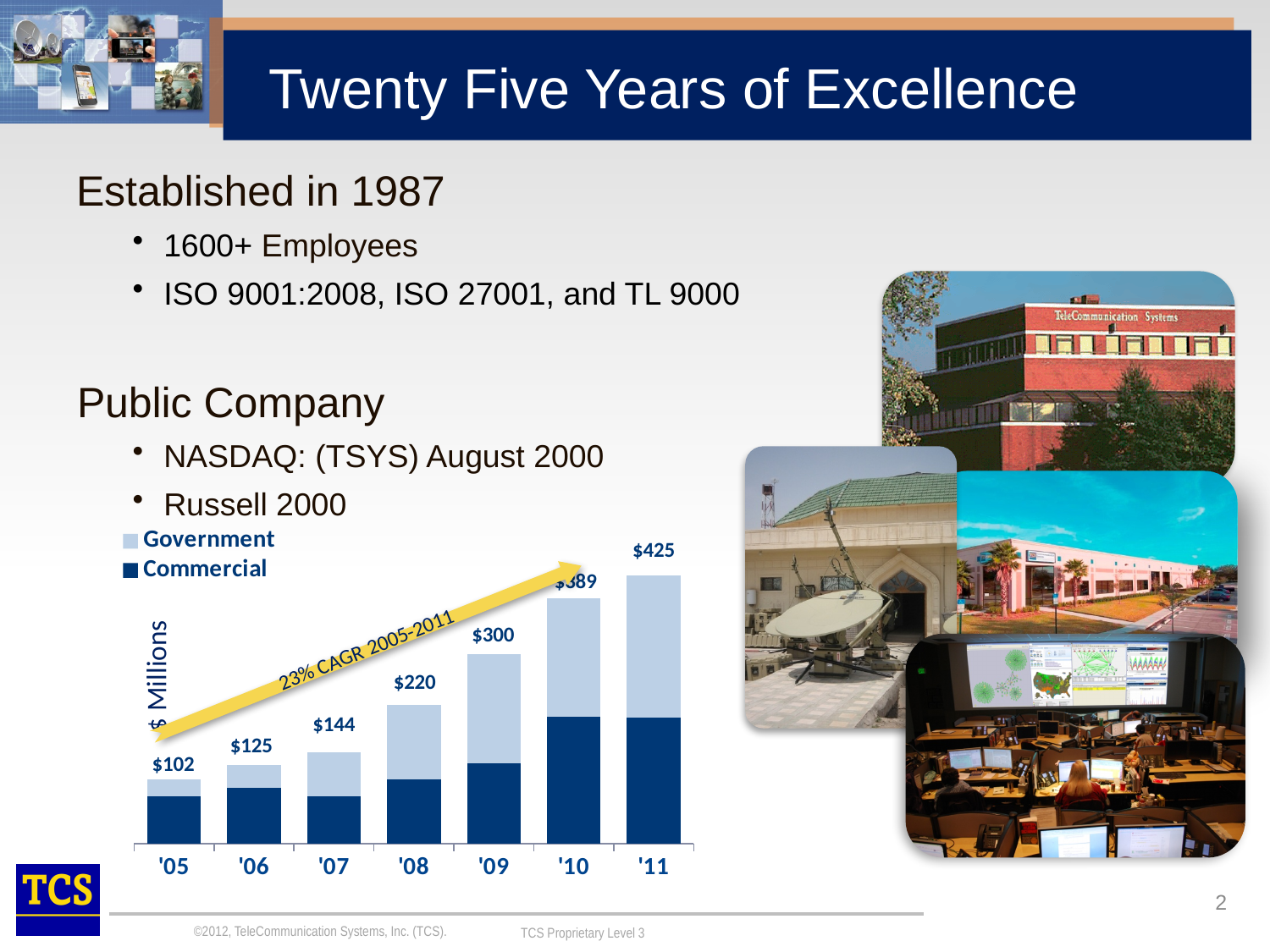
What kind of chart is shown on the slide? bar chart Which is larger, the total for '09 or the total for '07? '09 What is the total value labeled for '11? $425 Which year has the lowest total in the chart? '05 What is the total value labeled for '05? $102 What are the two series named in the chart's legend? Government and Commercial What is the difference between the total for '11 and the total for '05? $323 How many years are shown along the x axis of the chart? 7 What is the total value labeled for '08? $220 How many series does the chart's legend list? 2 Do the totals rise or fall from '05 to '11? rise Which year has the highest total in the chart? '11